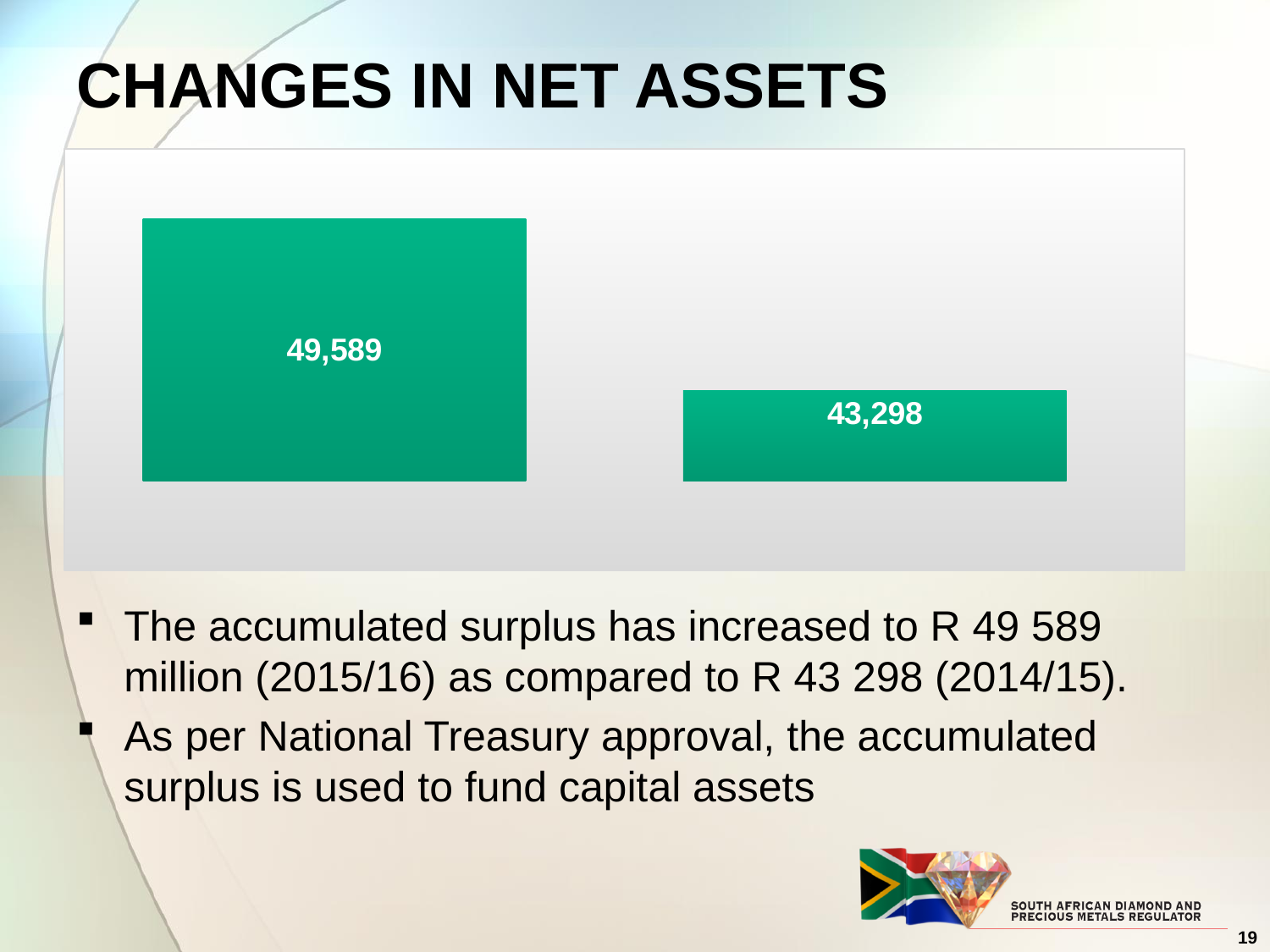
Which bar has the lowest value, the left or the right? right Which bar has the highest value, the left or the right? left How many bars are plotted in the chart? 2 What colour are the bars in the chart? green What value is labelled on the right bar of the chart? 43,298 What kind of chart is shown on the slide? bar chart Do the bar values rise or fall from left to right? fall According to the slide text, which financial year does the bar labelled 43,298 represent? 2014/15 What is the difference between the values of the left bar and the right bar? 6,291 According to the slide text, which financial year does the bar labelled 49,589 represent? 2015/16 What value is labelled on the left bar of the chart? 49,589 Is the value of the left bar larger or smaller than the value of the right bar? larger